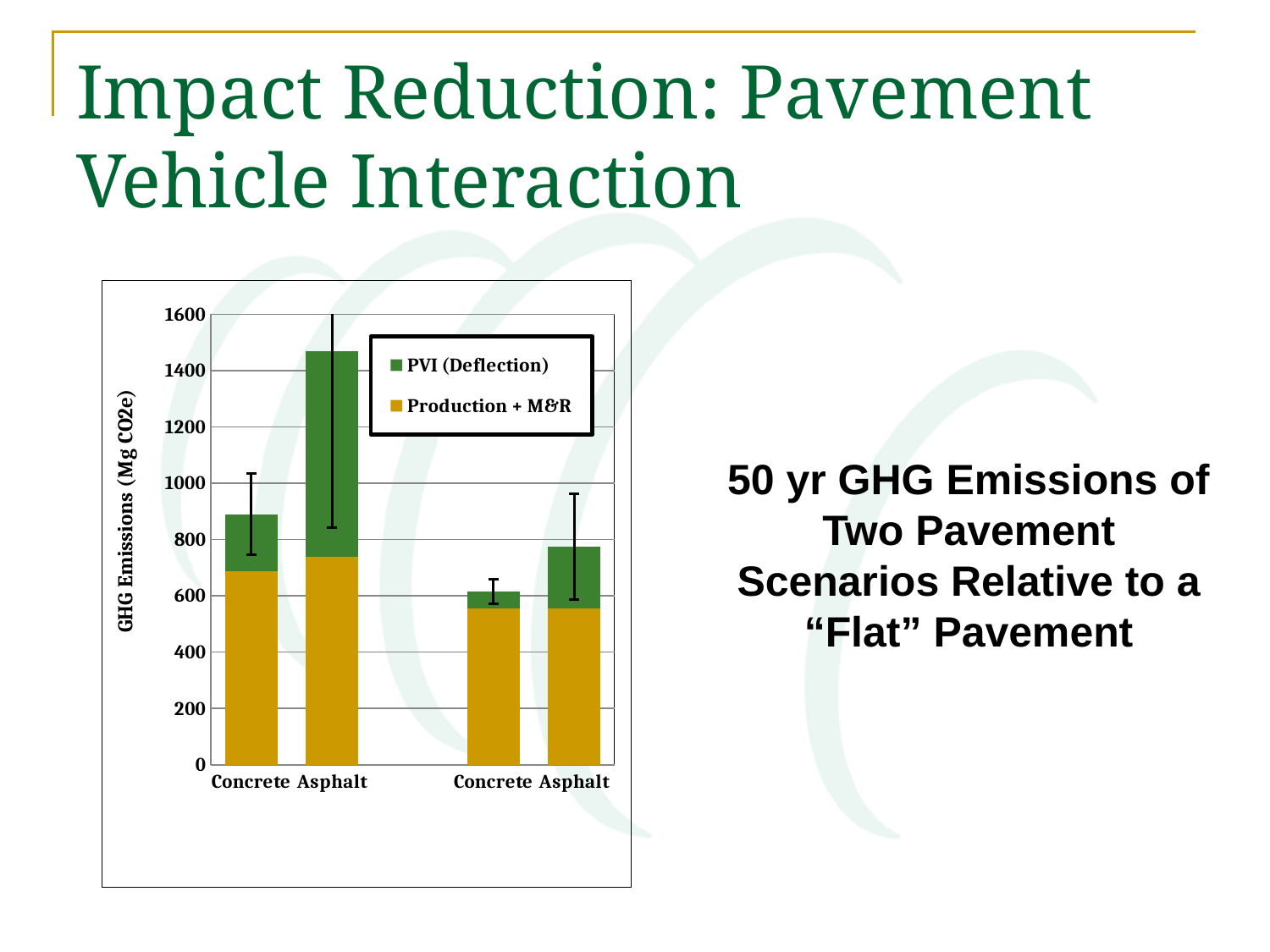
Is the total value for the Concrete bar in the right pair greater or less than 800? less What kind of chart is shown on the slide? Stacked bar chart Which bar has the highest total GHG emissions? Asphalt (left pair) How many bars are plotted in the chart? 4 Is the total value for the Concrete bar in the left pair greater or less than 1000? less How many series does the chart legend list? 2 Is the total value for the Asphalt bar in the left pair greater or less than 1200? greater Which bar has the lowest total GHG emissions? Concrete (right pair) Which colour represents PVI (Deflection) in the chart legend? Green What is the label on the vertical axis of the chart? GHG Emissions (Mg CO2e) Which has the larger total: the Concrete bar in the left pair or the Asphalt bar in the right pair? Concrete (left pair)